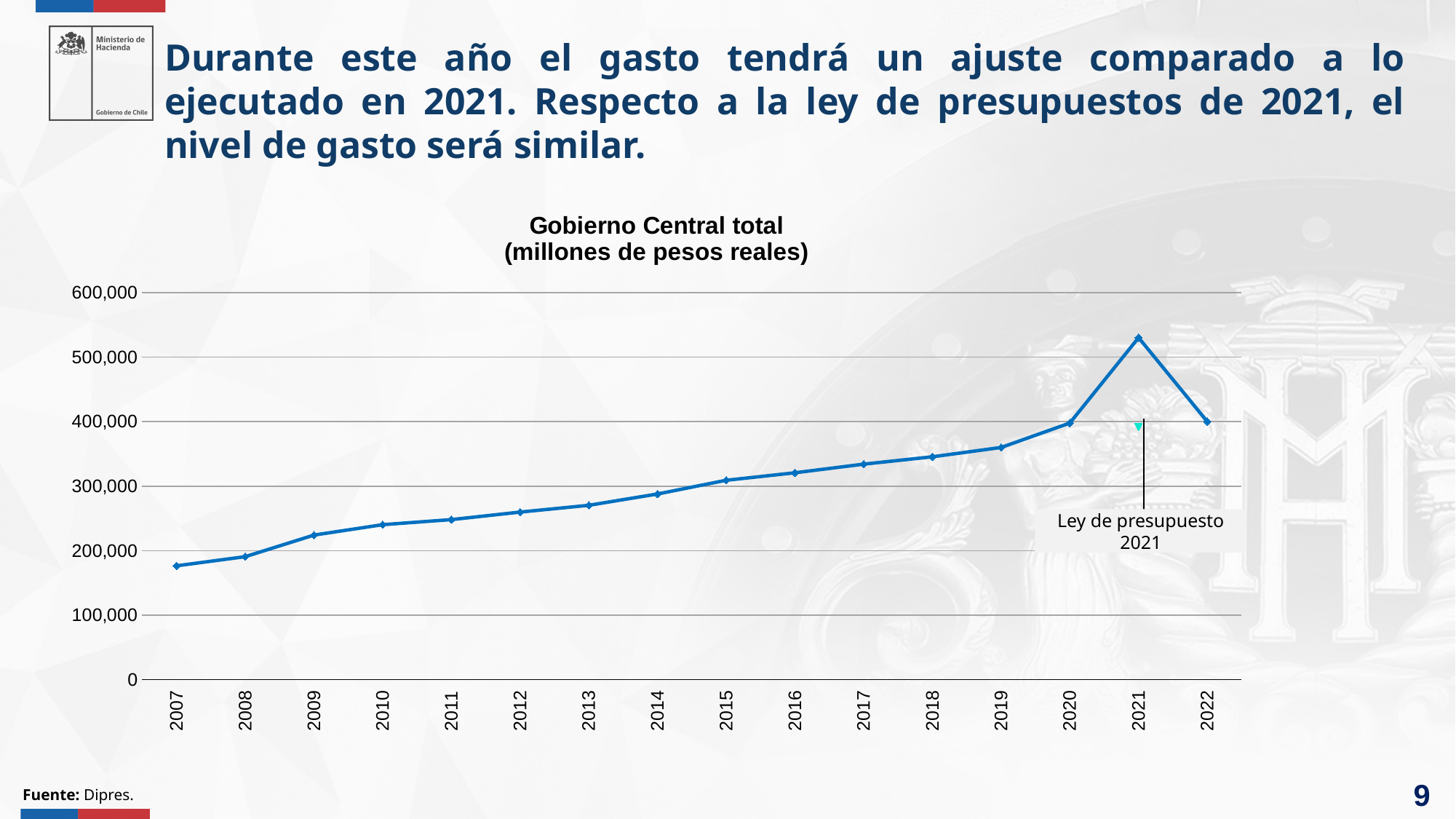
Is the value for 2021 greater or less than 500,000? greater Is the value for 2019 greater or less than 300,000? greater What is the title of the chart? Gobierno Central total (millones de pesos reales) Do the values rise or fall from 2007 to 2021? rise What kind of chart is shown on the slide? line chart Which is larger, the value for 2021 or the value for 2022? 2021 Is the value for 2007 greater or less than 200,000? less Which year has the highest value in the chart? 2021 How many years are plotted on the x axis of the chart? 16 Which is larger, the value for 2008 or the value for 2009? 2009 Which year has the lowest value in the chart? 2007